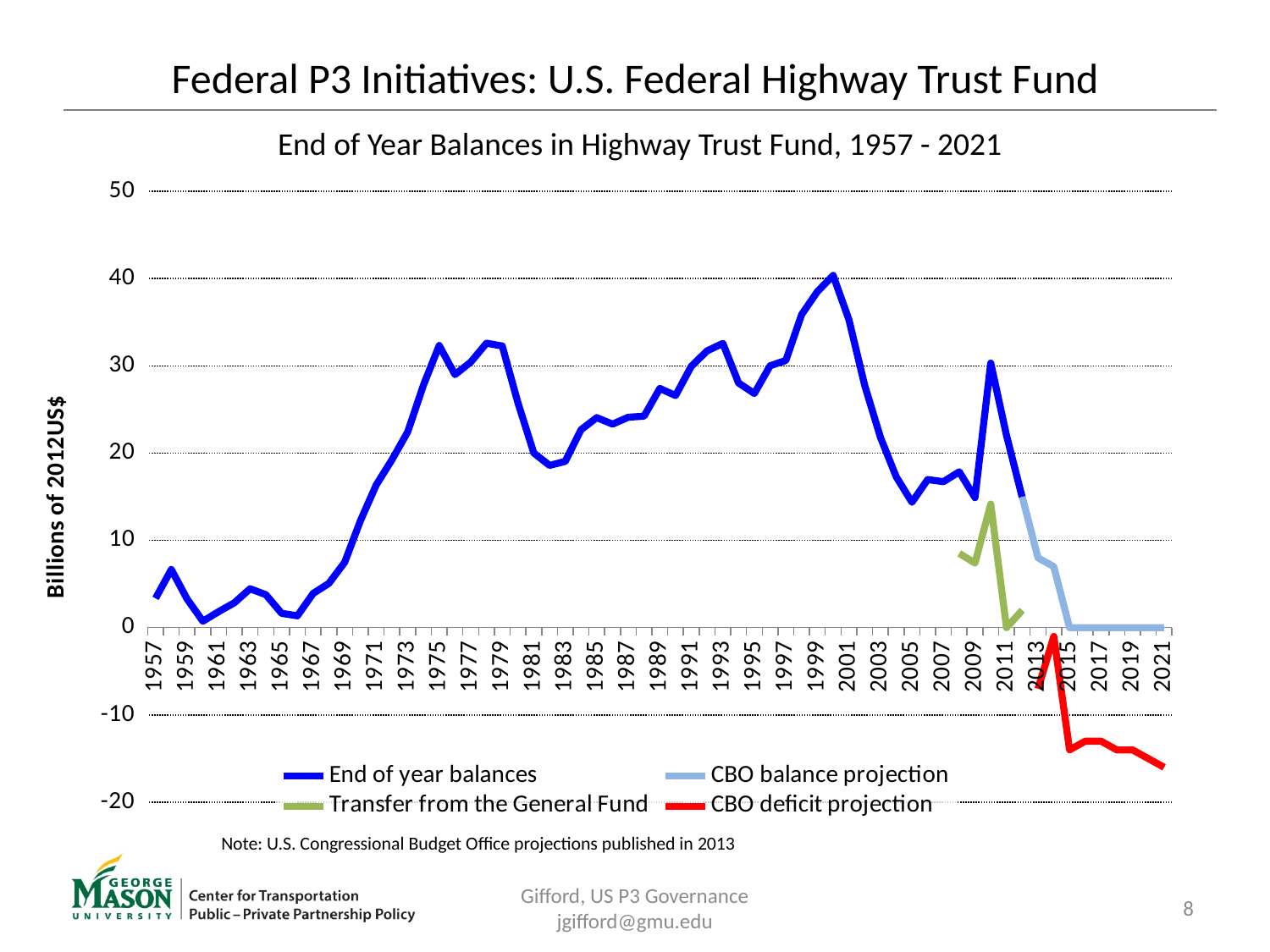
Does the End of year balances line rise or fall between 1969 and 1975? rise What is the label on the vertical axis of the chart? Billions of 2012US$ Which is larger, the End of year balances value for 2000 or for 1990? 2000 How many series does the chart legend list? 4 Is the CBO deficit projection value for 2021 greater or less than -10? less Is the End of year balances value for 1975 greater or less than 30? greater Is the End of year balances value for 1961 greater or less than 10? less What is the title of the chart? End of Year Balances in Highway Trust Fund, 1957 - 2021 What kind of chart is shown on the slide? line chart In which year does the End of year balances line reach its highest value? 2000 Does the CBO deficit projection line rise or fall between 2015 and 2021? fall